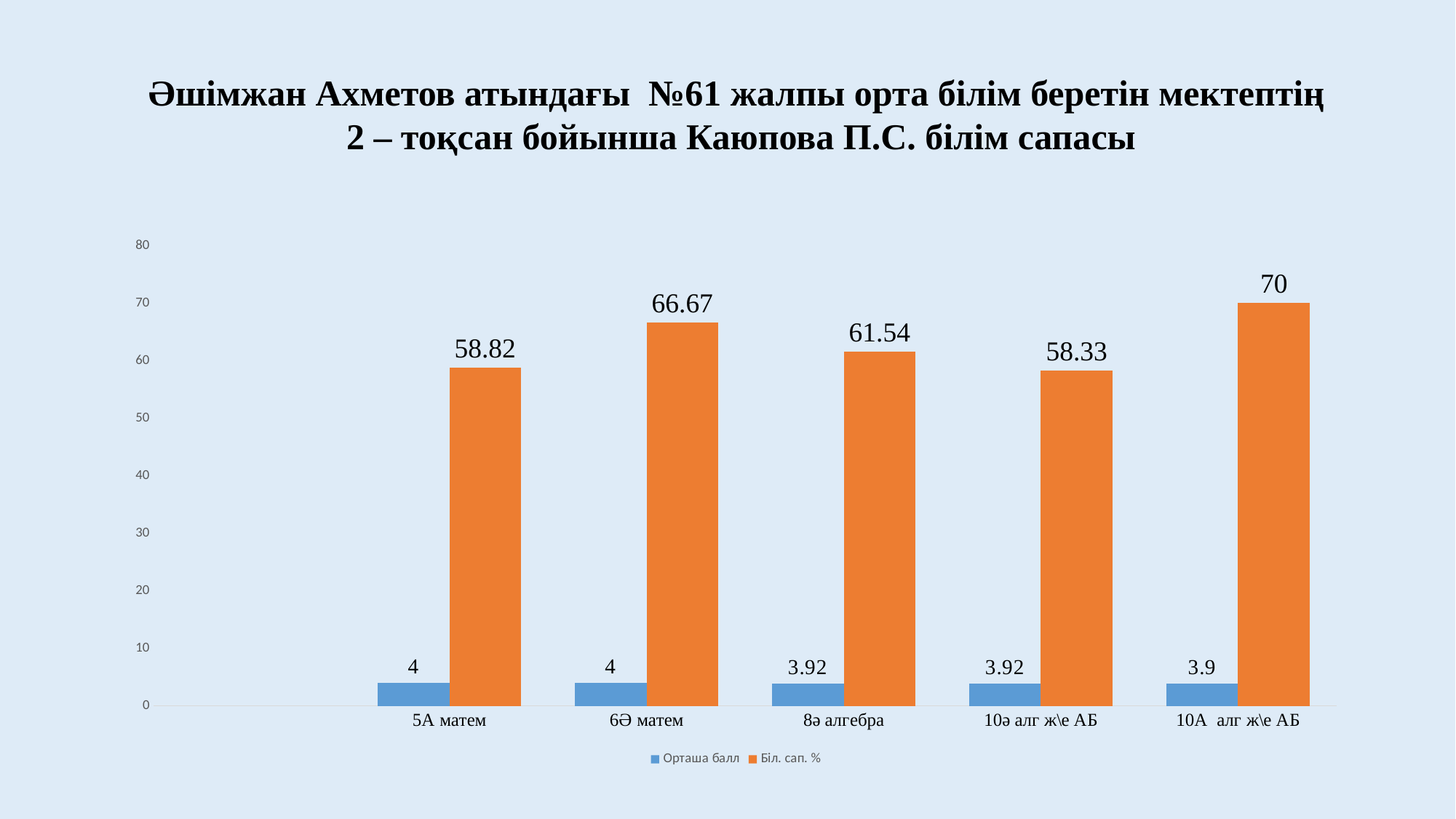
What is the Орташа балл value for 10А алг ж\е АБ? 3.9 What is the Біл. сап. % value for 6Ә матем? 66.67 Which category has the highest Біл. сап. % value? 10А алг ж\е АБ Is the Біл. сап. % value for 10ә алг ж\е АБ greater or less than 60? less How many categories are shown on the x axis? 5 What is the difference between the Біл. сап. % values for 10А алг ж\е АБ and 5А матем? 11.18 Which has a larger Біл. сап. % value, 6Ә матем or 8ә алгебра? 6Ә матем What kind of chart is shown on the slide? bar chart What is the Біл. сап. % value for 8ә алгебра? 61.54 Which colour represents the Біл. сап. % series? orange How many series does the legend list? 2 Which category has the lowest Біл. сап. % value? 10ә алг ж\е АБ